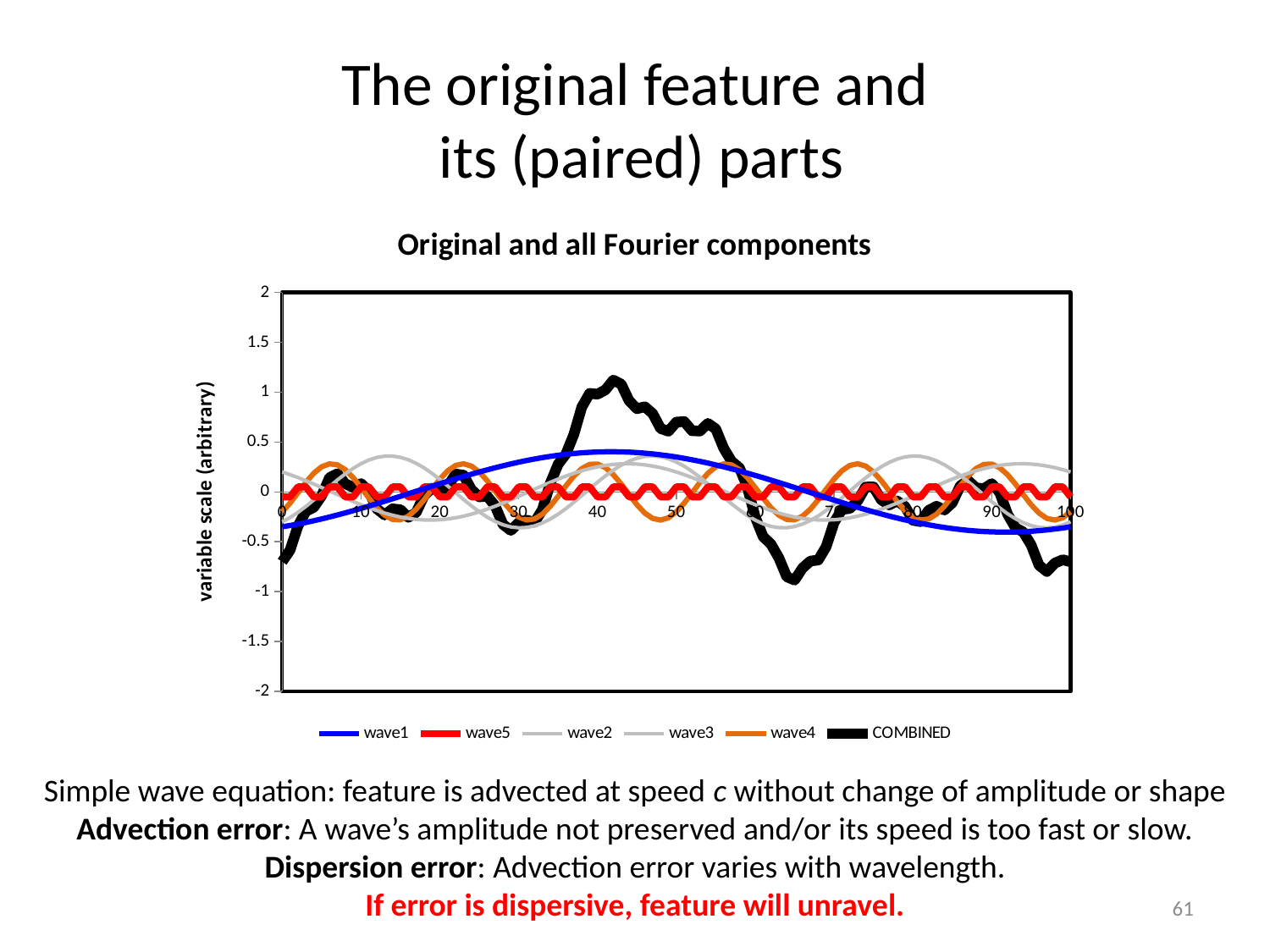
What is the title of the chart? Original and all Fourier components Does wave1 rise or fall as x goes from 0 to 40? rise Is the peak value of the COMBINED series near x = 40 greater or less than 1? greater Is the maximum value of wave1 greater or less than 1? less Is the lowest value of the COMBINED series near x = 65 greater or less than -0.5? less At x = 40, which is larger, the COMBINED series or wave1? COMBINED Which series reaches the lowest value on the chart? COMBINED How many series does the legend list? 6 What kind of chart is shown on the slide? line chart Which series reaches the highest value on the chart? COMBINED What is the label on the y axis of the chart? variable scale (arbitrary)